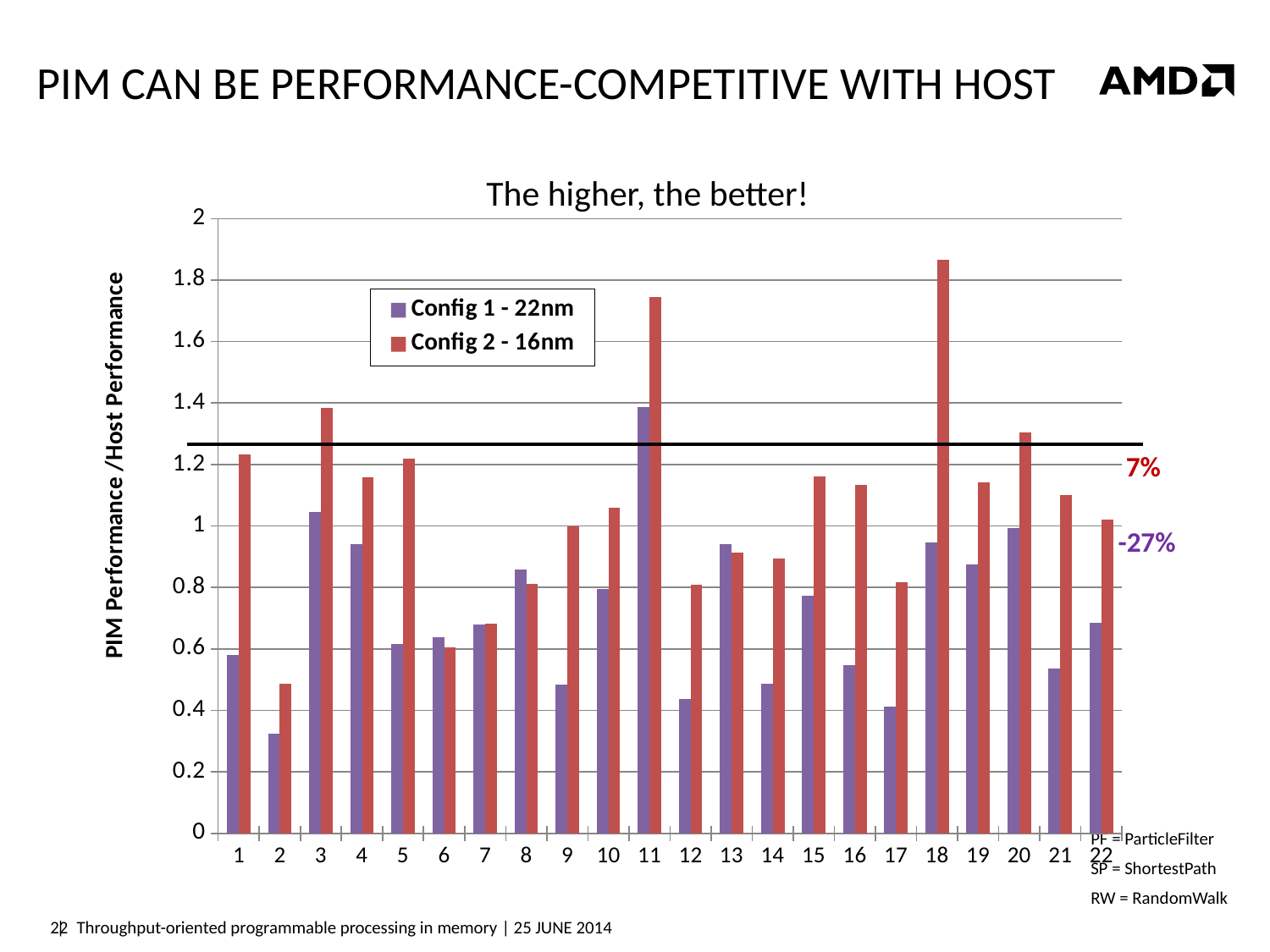
Which category has the highest value for Config 1 - 22nm? 11 What kind of chart is shown on the slide? bar chart Is the Config 2 - 16nm value for category 18 greater or less than 1.8? greater For Config 2 - 16nm, which is larger, the value for category 3 or the value for category 11? category 11 Is the Config 1 - 22nm value for category 2 greater or less than 0.4? less For category 1, which series has the larger value, Config 1 - 22nm or Config 2 - 16nm? Config 2 - 16nm How many categories are shown along the x axis? 22 Is the Config 2 - 16nm value for category 6 greater or less than 0.8? less How many series does the legend list? 2 What is the title of the chart? The higher, the better! Which category has the highest value for Config 2 - 16nm? 18 Which category has the lowest value for Config 1 - 22nm? 2